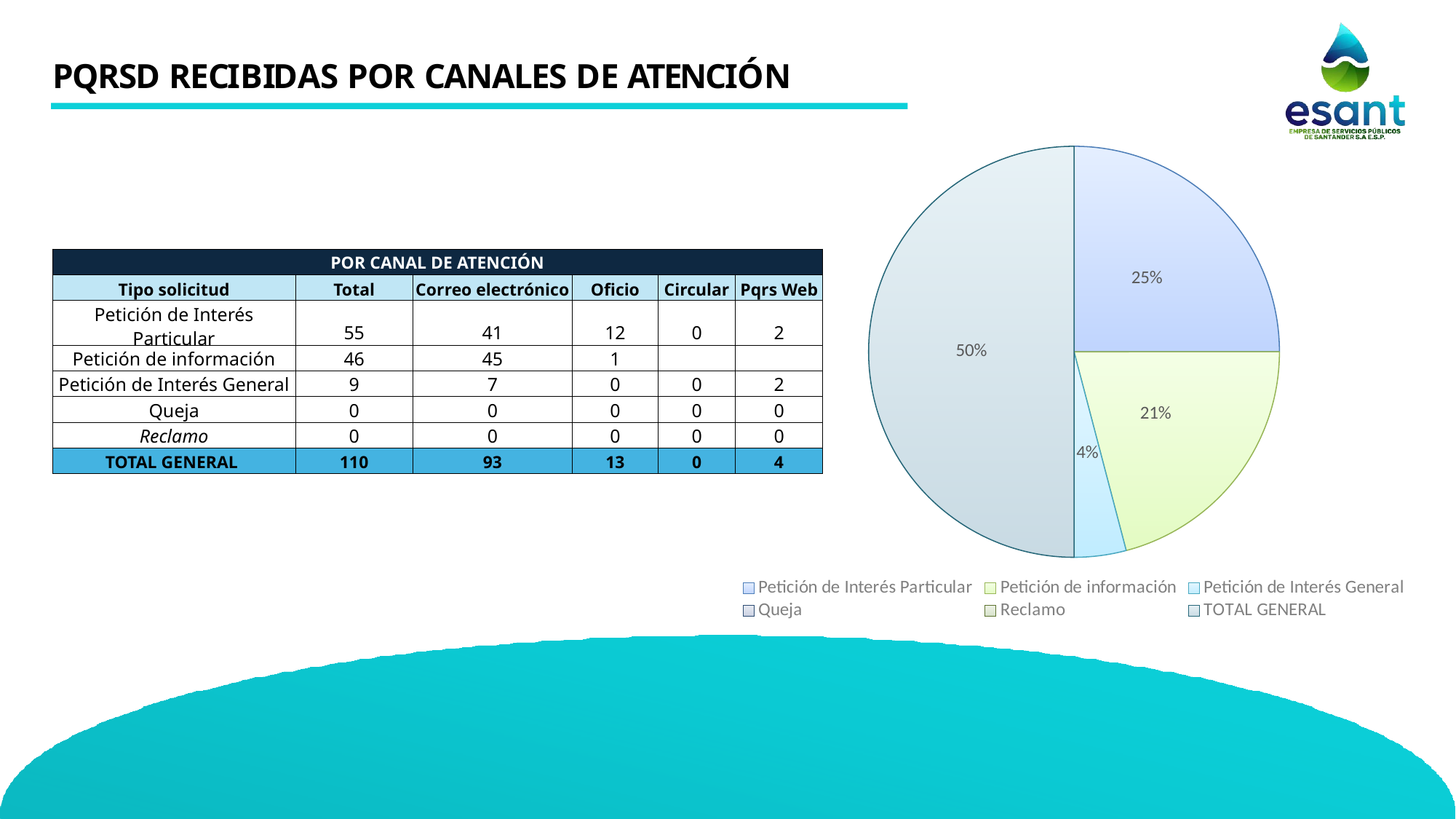
In the pie chart, what is the difference in percentage points between the Petición de Interés Particular slice and the Petición de información slice? 4 In the pie chart, what share is labelled for TOTAL GENERAL? 50% What colour is the Petición de información slice in the pie chart? light green In the pie chart, what share is labelled for Petición de información? 21% In the pie chart, what share is labelled for Petición de Interés General? 4% In the pie chart, which slice is larger: Petición de Interés Particular or Petición de información? Petición de Interés Particular How many entries does the legend of the pie chart list? 6 What kind of chart is shown on the slide? pie chart Among the slices with visible labels in the pie chart, which is the smallest? Petición de Interés General Which slice of the pie chart is the largest? TOTAL GENERAL How many slices in the pie chart have a percentage label shown? 4